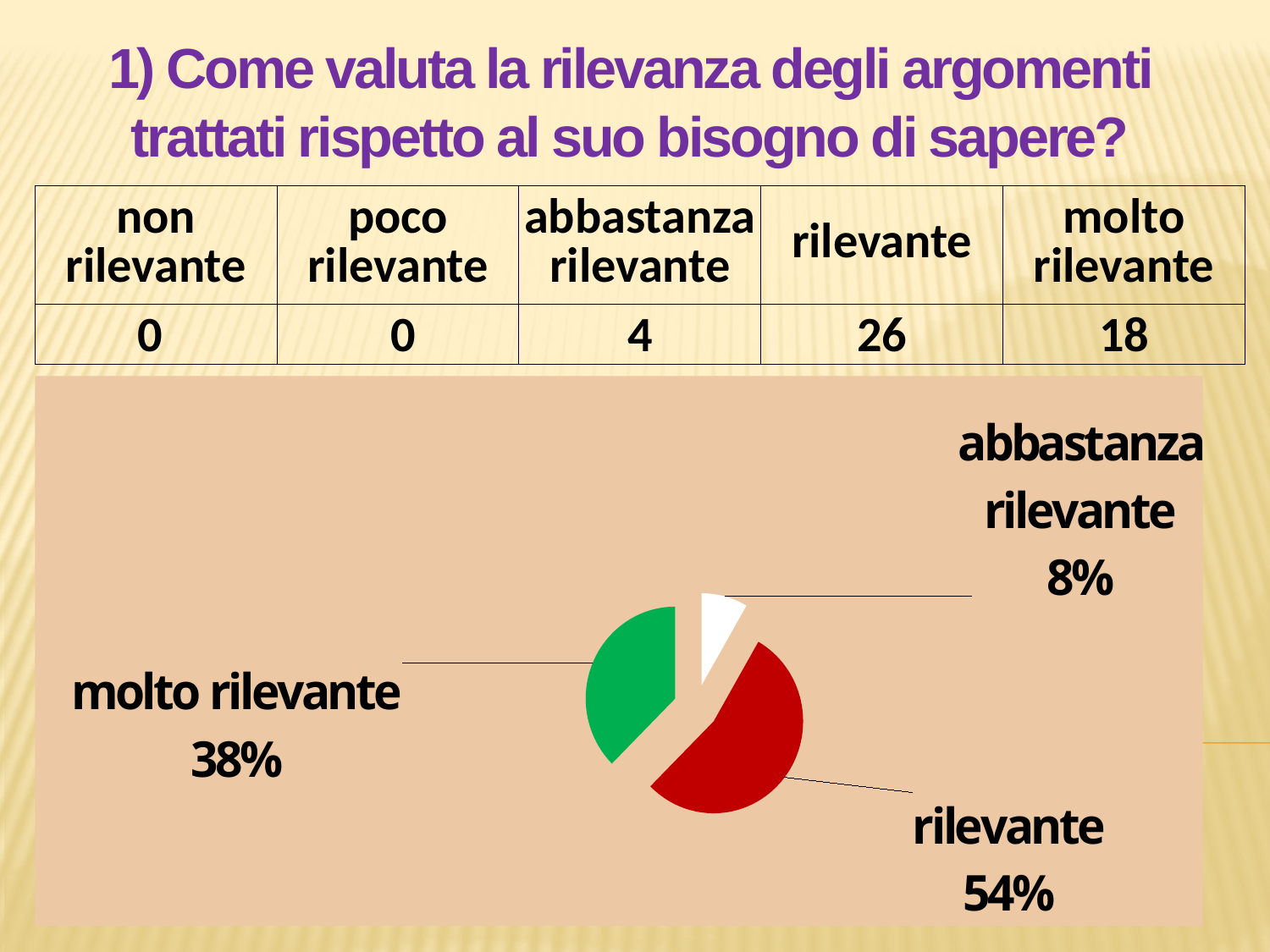
What is the difference in percentage points between the "molto rilevante" and "abbastanza rilevante" slices? 30 What type of chart is shown on the slide? pie chart What colour is the "rilevante" slice in the pie chart? red What share of the pie chart does "molto rilevante" represent? 38% What share of the pie chart does "rilevante" represent? 54% How many labelled slices does the pie chart have? 3 Which category has the largest slice in the pie chart? rilevante What share of the pie chart does "abbastanza rilevante" represent? 8% Which category has the smallest slice in the pie chart? abbastanza rilevante Which slice is larger, "molto rilevante" or "abbastanza rilevante"? molto rilevante What is the difference in percentage points between the "rilevante" and "molto rilevante" slices? 16 Which slice is larger, "rilevante" or "molto rilevante"? rilevante